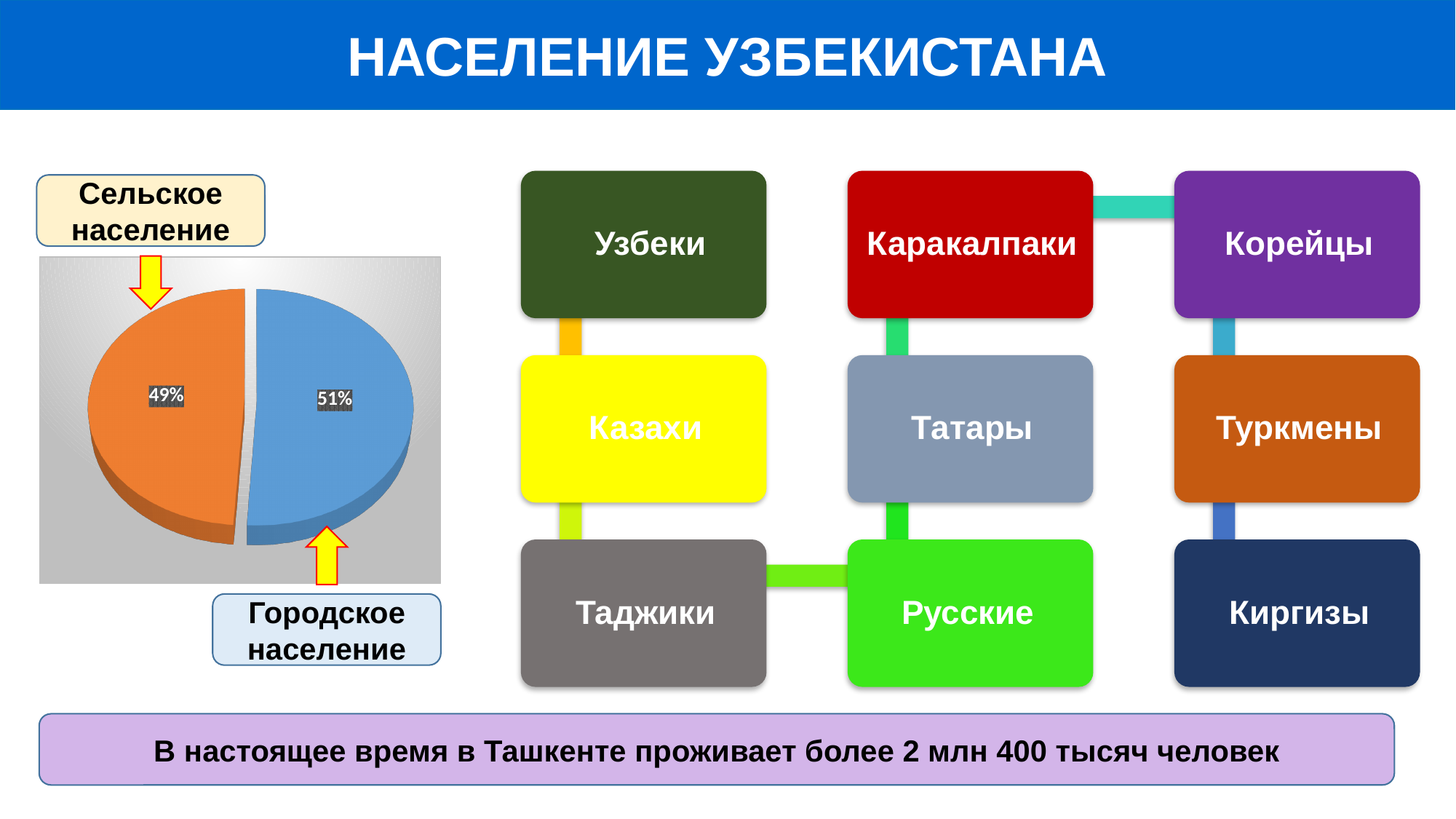
What kind of chart is shown on the left of the slide? pie chart What share of the pie chart is labelled Городское население? 51% What colour is the Сельское население slice of the pie chart? orange What share of the pie chart is labelled Сельское население? 49% Which slice of the pie chart is the smallest? Сельское население Which slice of the pie chart is larger, Сельское население or Городское население? Городское население What colour is the Городское население slice of the pie chart? blue What is the difference in percentage points between the Городское население and Сельское население slices of the pie chart? 2 How many slices does the pie chart have? 2 Which slice of the pie chart is the largest? Городское население Is the value for Городское население in the pie chart greater or less than 50%? greater Is the value for Сельское население in the pie chart greater or less than 50%? less